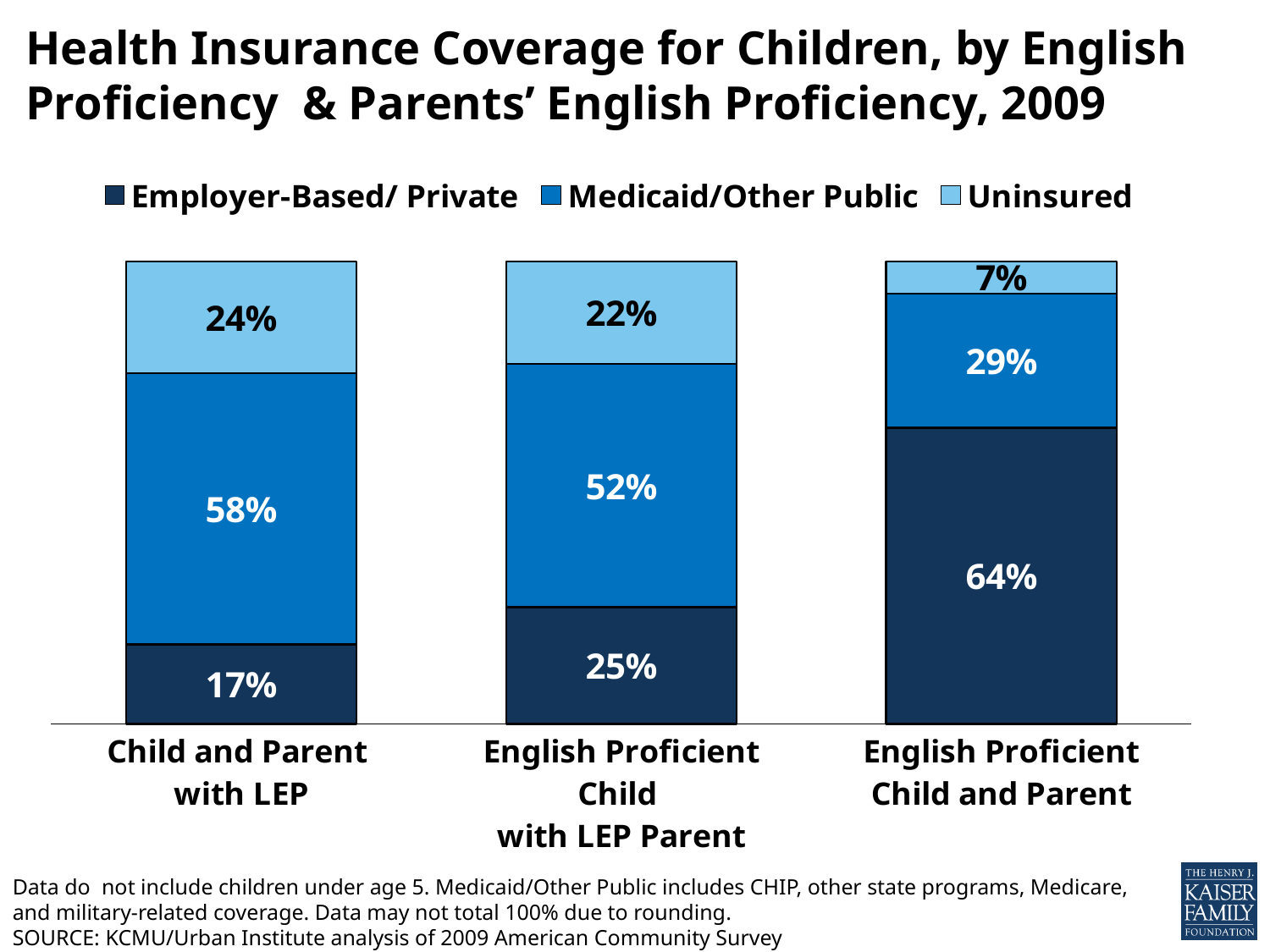
How many series does the legend list? 3 Which is larger: the Uninsured share for Child and Parent with LEP or for English Proficient Child with LEP Parent? Child and Parent with LEP What kind of chart is shown? Stacked bar chart What is the Employer-Based/ Private share for Child and Parent with LEP? 17% What is the Medicaid/Other Public share for English Proficient Child with LEP Parent? 52% What is the Employer-Based/ Private share for English Proficient Child and Parent? 64% What is the total of the three segments for English Proficient Child with LEP Parent? 99% Which category has the highest Medicaid/Other Public share? Child and Parent with LEP How many categories are shown on the x axis? 3 Which category has the lowest Uninsured share? English Proficient Child and Parent What is the difference in Employer-Based/ Private share between English Proficient Child and Parent and Child and Parent with LEP? 47 percentage points What is the Uninsured share for Child and Parent with LEP? 24%